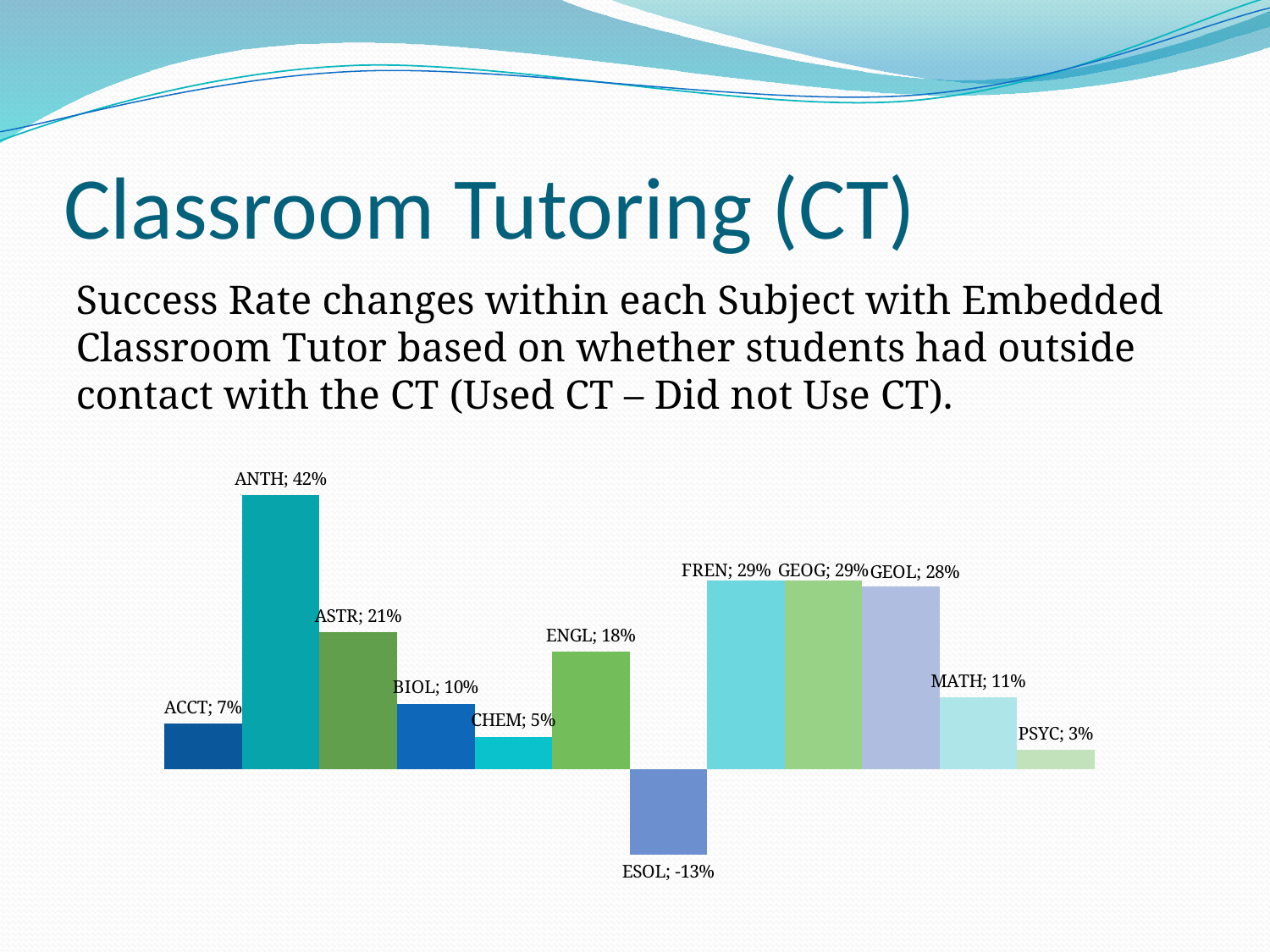
What is the value for GEOL? 28% What is the value for CHEM? 5% Which subject has the lowest value? ESOL What is the value for ANTH? 42% What is the value for ESOL? -13% Which is larger, the value for ACCT or the value for PSYC? ACCT What kind of chart is shown on the slide? Bar chart What is the difference between the values for FREN and MATH? 18% Which is larger, the value for ENGL or the value for BIOL? ENGL Which subject has the highest value? ANTH How many subjects are shown in the chart? 12 What is the difference between the values for ANTH and ASTR? 21%